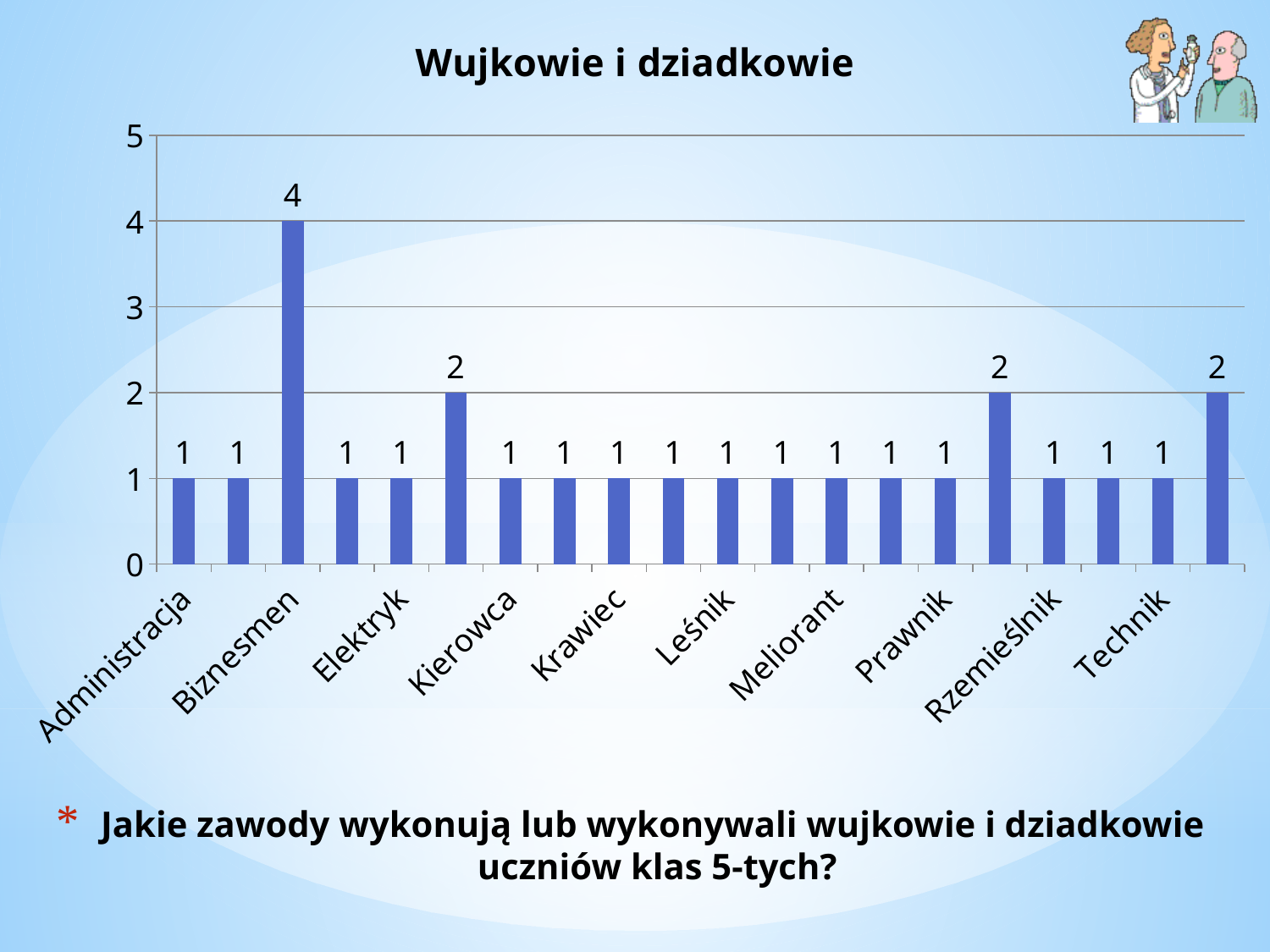
What is the title of the chart? Wujkowie i dziadkowie What is the value for Leśnik? 1 Which category has the highest value? Biznesmen What is the highest value shown on the vertical axis? 5 What kind of chart is shown on the slide? Bar chart What is the value for Technik? 1 How many bars are plotted in the chart? 20 Is the value for Biznesmen greater or less than 3? greater Which is larger, the value for Biznesmen or the value for Prawnik? Biznesmen What is the value for Administracja? 1 What is the value for Biznesmen? 4 What is the difference between the values for Biznesmen and Kierowca? 3